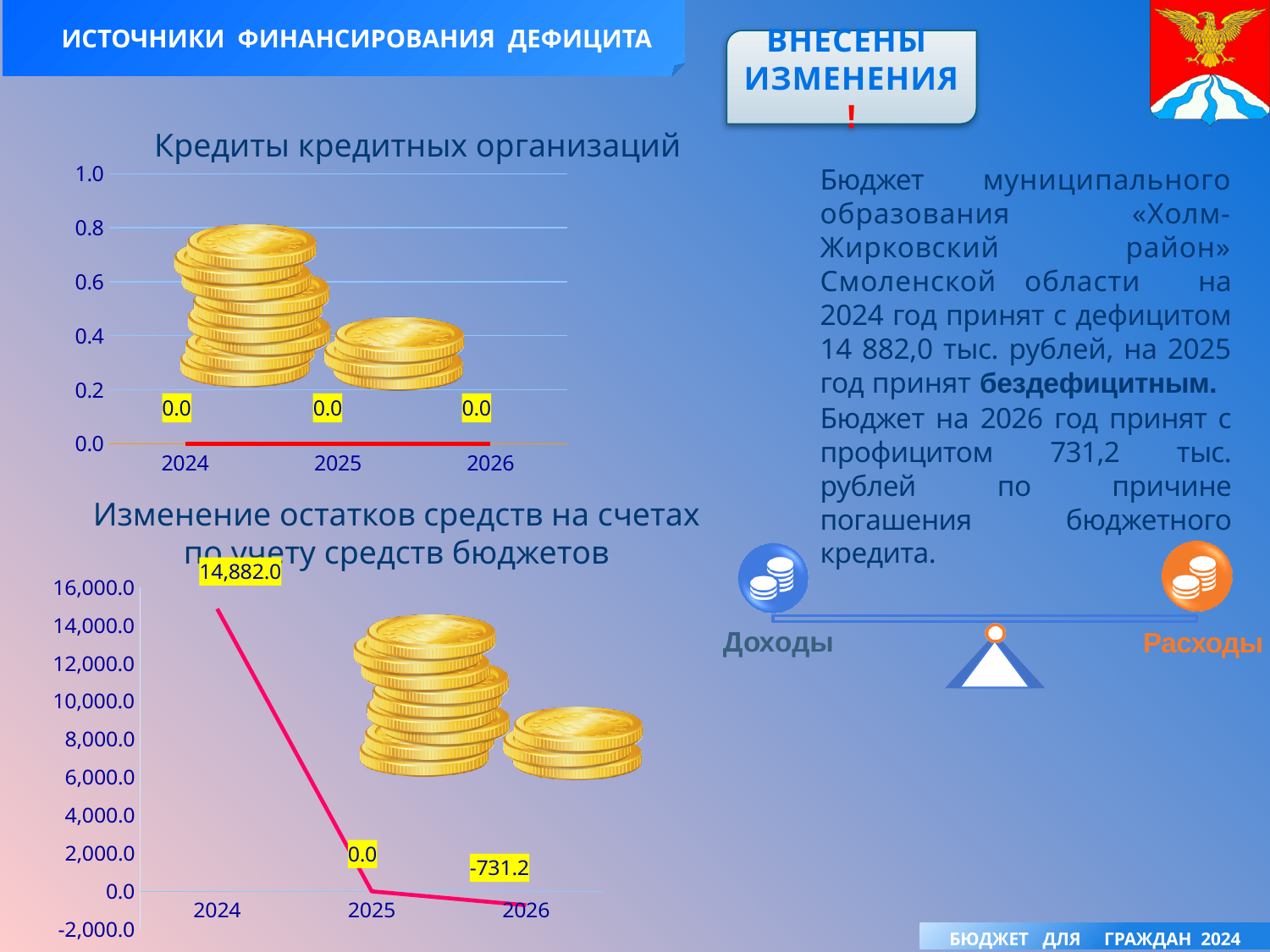
In the chart 'Изменение остатков средств на счетах по учету средств бюджетов', how many years are plotted? 3 In the chart 'Кредиты кредитных организаций', how many years are shown on the x axis? 3 In the chart 'Изменение остатков средств на счетах по учету средств бюджетов', what is the value for 2025? 0.0 In the chart 'Изменение остатков средств на счетах по учету средств бюджетов', what is the value for 2026? -731.2 In the chart 'Изменение остатков средств на счетах по учету средств бюджетов', do the values rise or fall from 2024 to 2026? fall In the chart 'Кредиты кредитных организаций', is the value for 2024 larger than, smaller than, or equal to the value for 2026? equal In the chart 'Изменение остатков средств на счетах по учету средств бюджетов', what is the difference between the 2024 value and the 2025 value? 14,882.0 What kind of chart is 'Изменение остатков средств на счетах по учету средств бюджетов'? line chart In the chart 'Изменение остатков средств на счетах по учету средств бюджетов', which year has the lowest value? 2026 In the chart 'Кредиты кредитных организаций', what is the value for 2025? 0.0 In the chart 'Изменение остатков средств на счетах по учету средств бюджетов', what is the value for 2024? 14,882.0 In the chart 'Изменение остатков средств на счетах по учету средств бюджетов', which year has the highest value? 2024